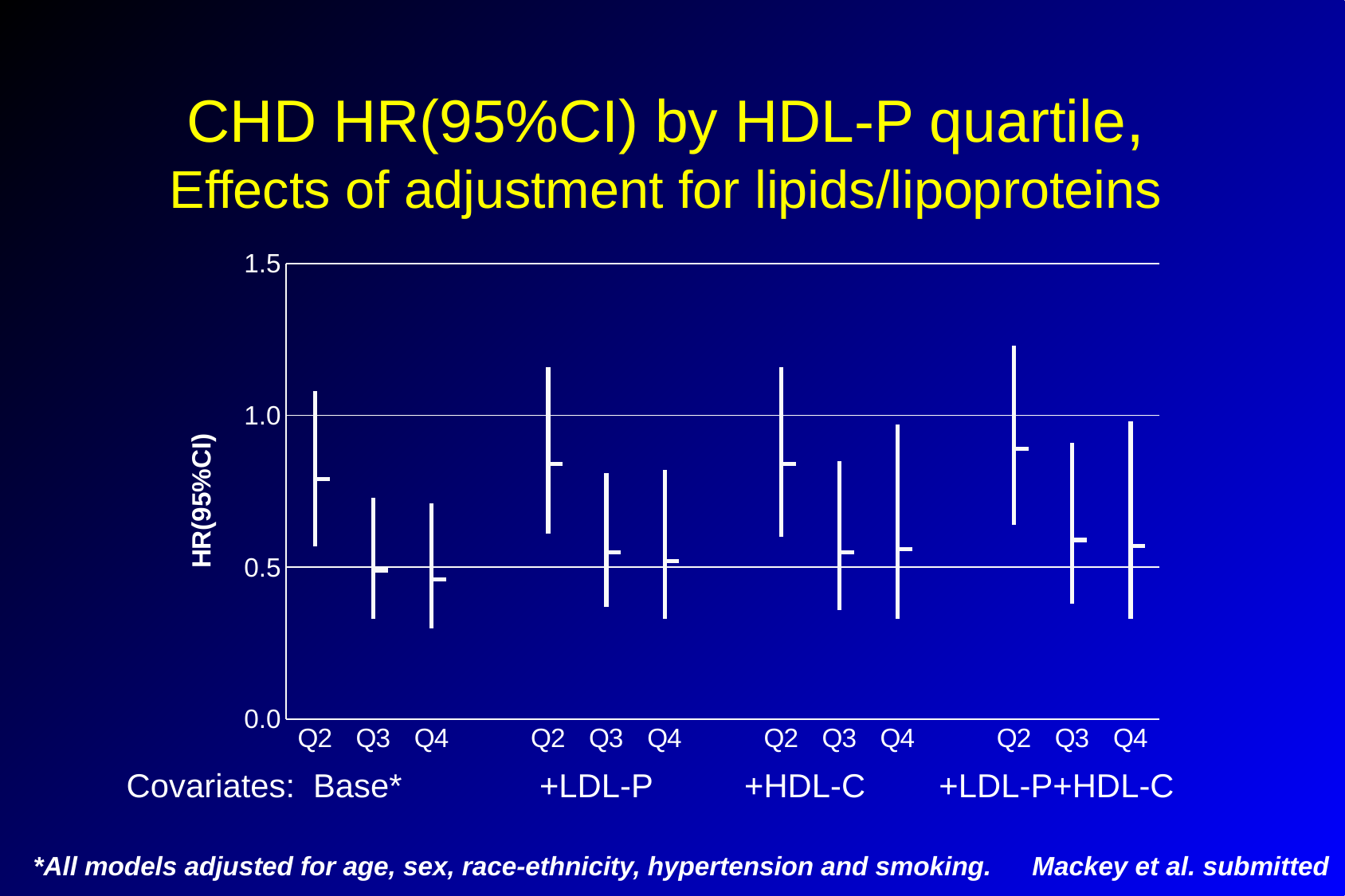
Within the Base* covariate group, which quartile has the highest point estimate? Q2 Is the upper end of the confidence interval for Q2 in the +LDL-P+HDL-C covariate group greater or less than 1.0? greater Is the point estimate for Q2 in the +LDL-P+HDL-C covariate group greater or less than 1.0? less How many point estimates (quartile markers) are plotted in total on the chart? 12 Is the point estimate for Q2 in the Base* covariate group greater or less than 0.5? greater What is the label on the y axis of the chart? HR(95%CI) How many covariate groups are shown along the x axis of the chart? 4 What is the title of the chart on the slide? CHD HR(95%CI) by HDL-P quartile, Effects of adjustment for lipids/lipoproteins Within the +LDL-P covariate group, do the point estimates rise or fall from Q2 to Q4? fall What is the highest value shown on the y axis of the chart? 1.5 In the +LDL-P covariate group, which has the larger point estimate, Q2 or Q4? Q2